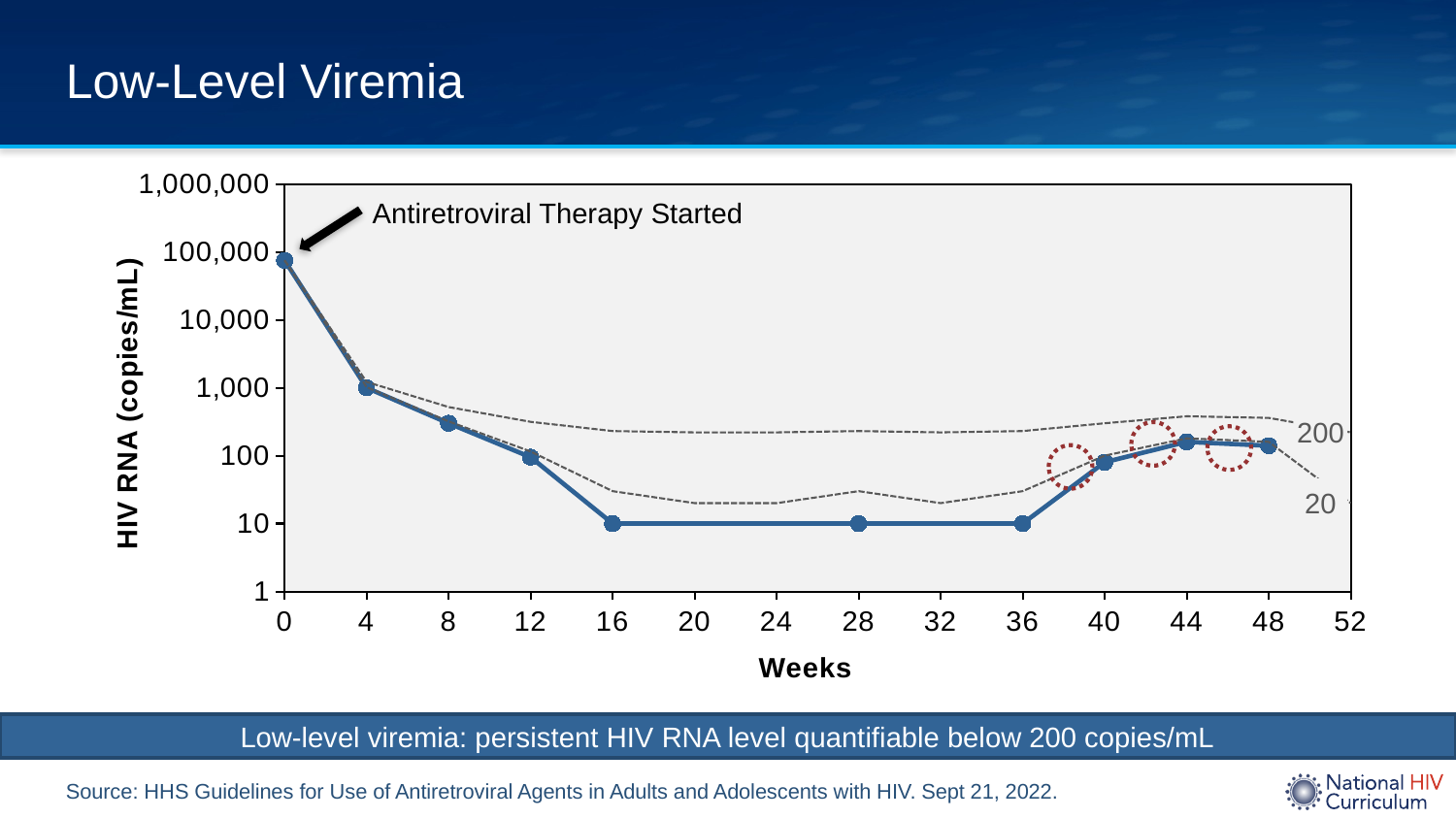
Which is larger, the HIV RNA value at week 0 or at week 48? week 0 What is the label on the y axis of the chart? HIV RNA (copies/mL) Is the HIV RNA value at week 0 greater or less than 10,000? greater What is the HIV RNA value at week 16? 10 Is the HIV RNA value at week 44 greater or less than 100? greater Does the HIV RNA value rise or fall between week 0 and week 16? fall What is the HIV RNA value at week 4? 1,000 What is the HIV RNA value at week 36? 10 At which week is the HIV RNA value highest? 0 What kind of chart is shown on the slide? line chart How many data points are plotted on the solid line? 10 Is the HIV RNA value at week 8 greater or less than 100? greater